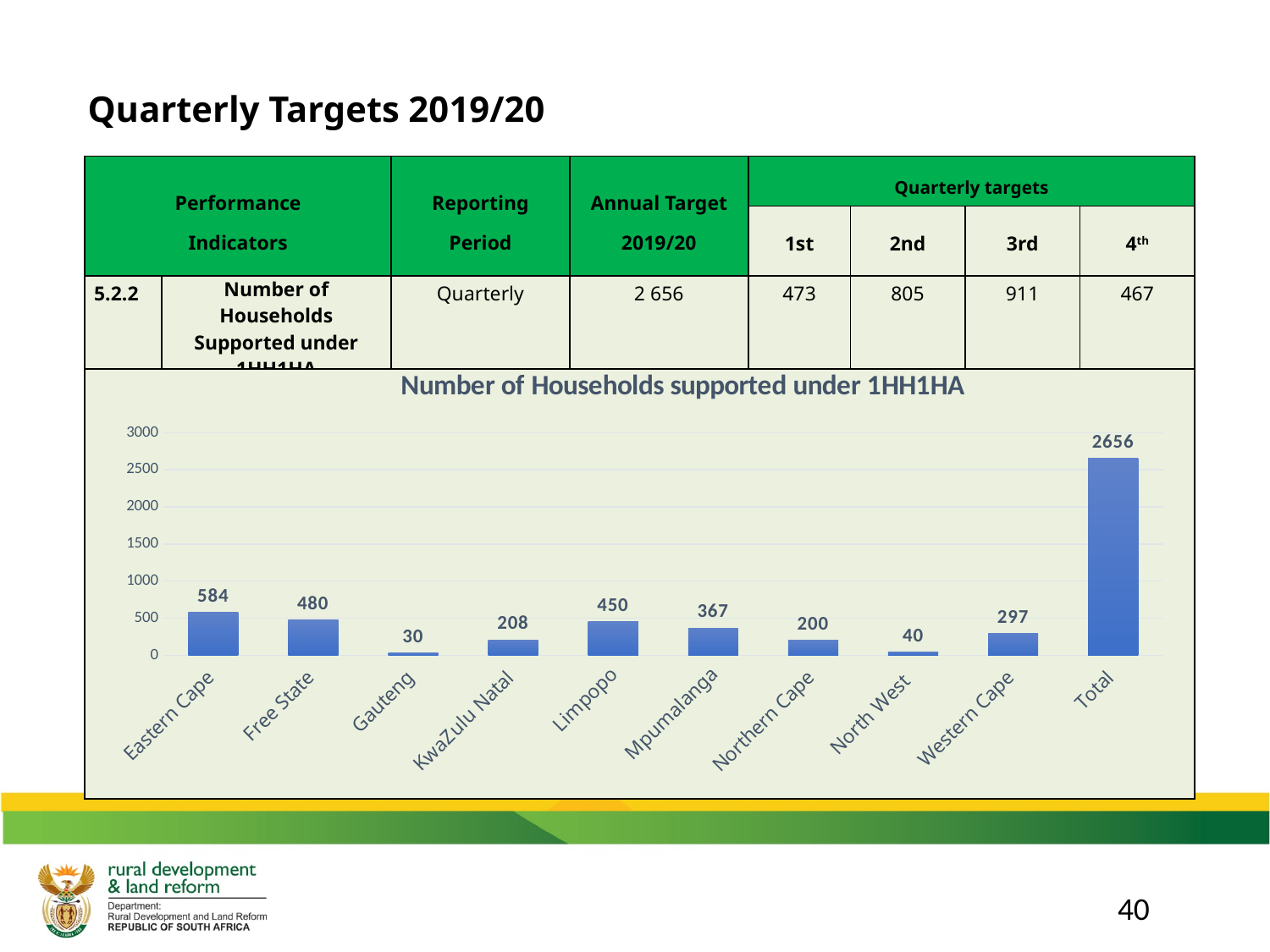
What is the title of the chart? Number of Households supported under 1HH1HA What type of chart is shown on the slide? bar chart Is the value for Total greater or less than 2500? greater How many bars are plotted in the chart, including the Total bar? 10 What is the value for Eastern Cape in the chart? 584 What is the value for Gauteng in the chart? 30 Which is larger, the value for Limpopo or the value for Western Cape? Limpopo What is the value shown for the Total bar? 2656 Excluding the Total bar, which province has the highest number of households supported? Eastern Cape Which province has the lowest number of households supported? Gauteng What is the value for Mpumalanga in the chart? 367 What is the difference between the values for Eastern Cape and Free State? 104